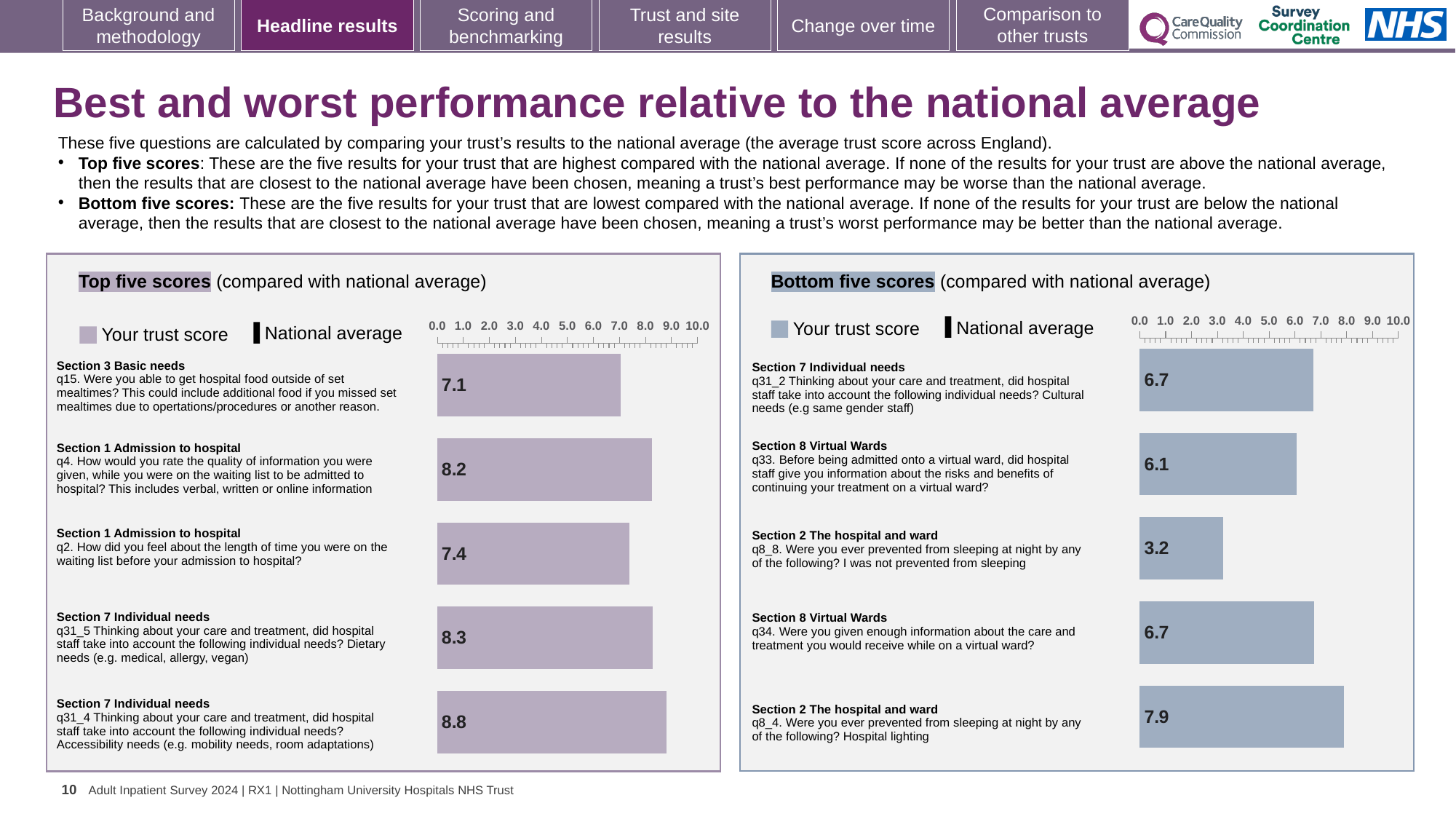
In the 'Top five scores' chart, which has the larger trust score: q4 (quality of information on the waiting list) or q2 (length of time on the waiting list)? q4 In the 'Bottom five scores' chart, is the trust score for q8_8 (I was not prevented from sleeping) greater or less than 4.0? less In the 'Top five scores' chart, which question has the highest trust score? q31_4 (Accessibility needs) In the 'Top five scores' chart, what is the difference between the highest score (8.8) and the lowest score (7.1)? 1.7 In the 'Bottom five scores' chart, what is the difference between the score for q8_4 (Hospital lighting) and the score for q8_8 (I was not prevented from sleeping)? 4.7 How many questions are plotted in the 'Bottom five scores' chart? 5 In the 'Bottom five scores' chart, what is the trust score for q33 (information about risks and benefits of continuing treatment on a virtual ward)? 6.1 In the 'Bottom five scores' chart, which question has the lowest trust score? q8_8 (I was not prevented from sleeping) In the 'Bottom five scores' chart, what is the trust score for q34 (enough information about care and treatment on a virtual ward)? 6.7 What type of chart is the 'Top five scores' chart? Bar chart How many series does the legend of the 'Top five scores' chart list? 2 In the 'Top five scores' chart, what is the trust score for q15 (hospital food outside of set mealtimes)? 7.1